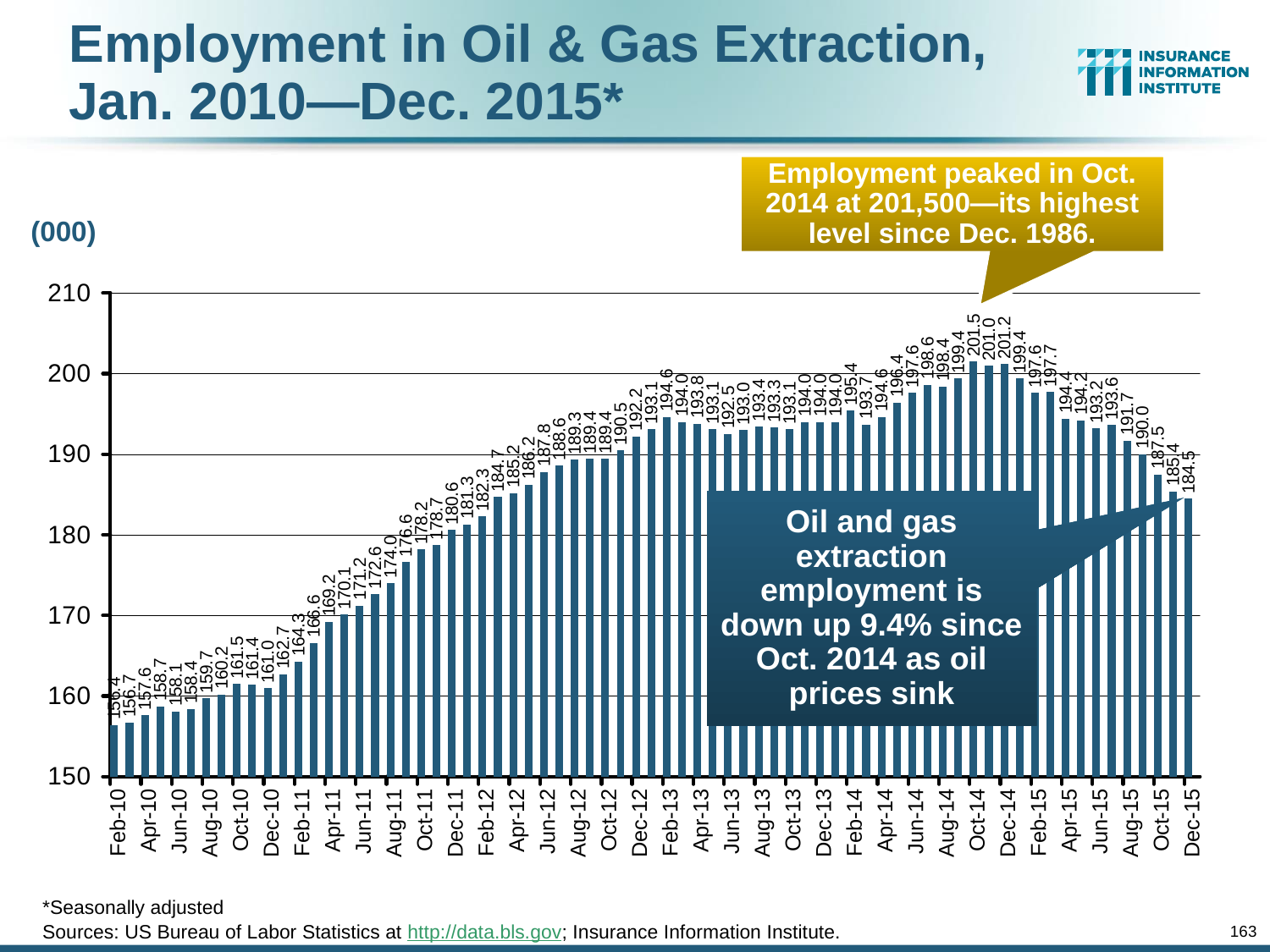
Do the values rise or fall from Oct-14 to Dec-15? fall Which is larger, the value for Oct-14 or the value for Dec-14? Oct-14 What type of chart is shown on the slide? bar chart In what units are the values on the chart expressed, according to the label above the y-axis? (000) What is the employment value for Dec-15? 184.5 Is the value for Dec-15 greater or less than 190? less According to the callout on the chart, in which month did employment peak? Oct. 2014 Which month has the highest employment value in the chart? Oct-14 What is the employment value for Dec-14? 201.2 What is the employment value for Oct-14? 201.5 What is the difference between the Oct-14 value and the Dec-15 value? 17.0 What is the employment value for Oct-15? 187.5